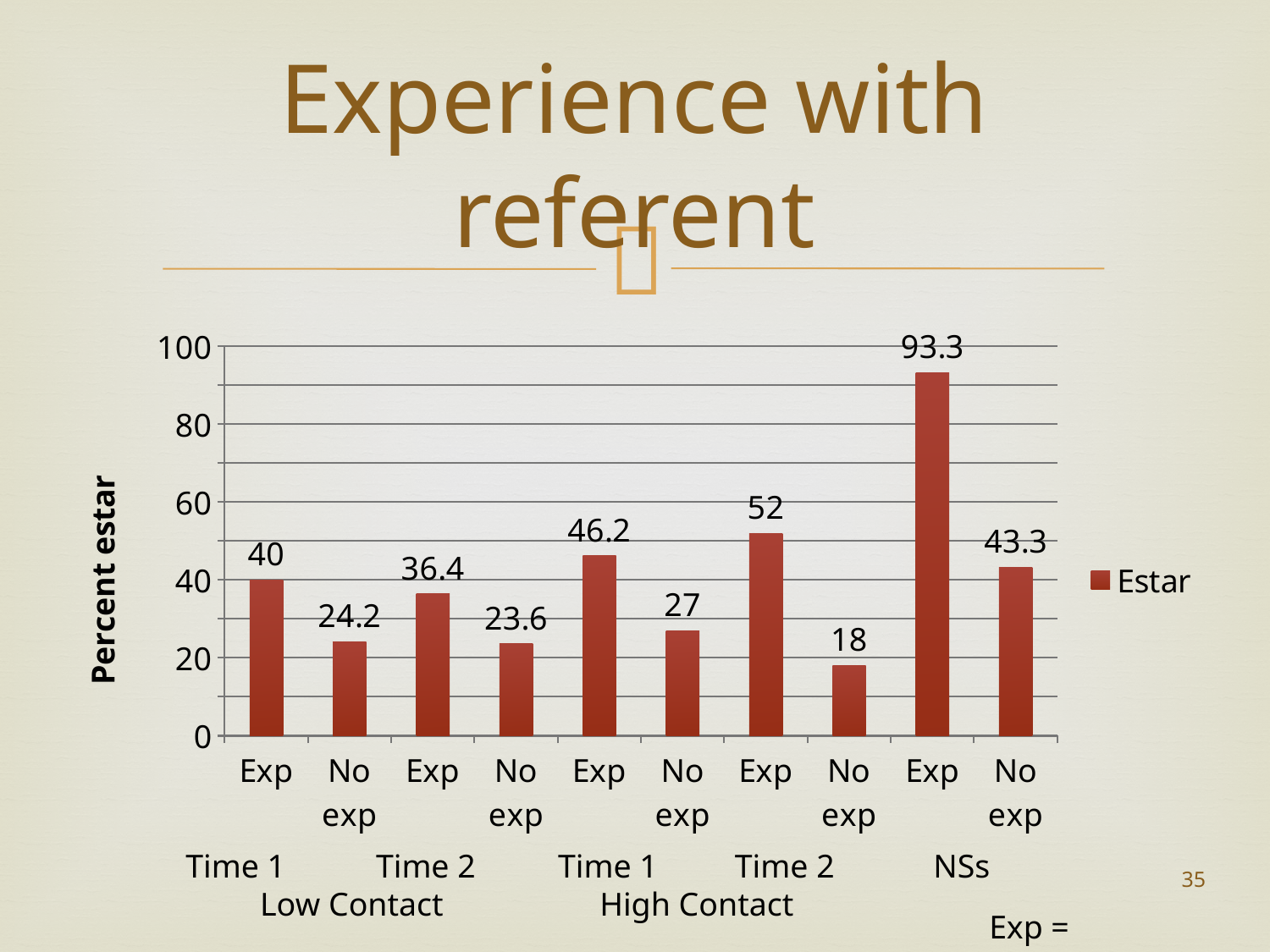
What is the value for Exp under Time 1, Low Contact? 40 What is the difference between the Exp values for Time 1 and Time 2 under High Contact? 5.8 Which is larger: the Exp value under Time 1, Low Contact or the Exp value under Time 1, High Contact? Exp under Time 1, High Contact What is the label on the vertical axis? Percent estar What is the value for No exp under Time 2, High Contact? 18 How many bars are plotted in the chart? 10 What is the difference between the Exp and No exp values under NSs? 50 What is the value for No exp under Time 2, Low Contact? 23.6 What type of chart is shown? Bar chart Which bar has the lowest value? No exp under Time 2, High Contact Which bar has the highest value? Exp under NSs What is the value for Exp under NSs? 93.3